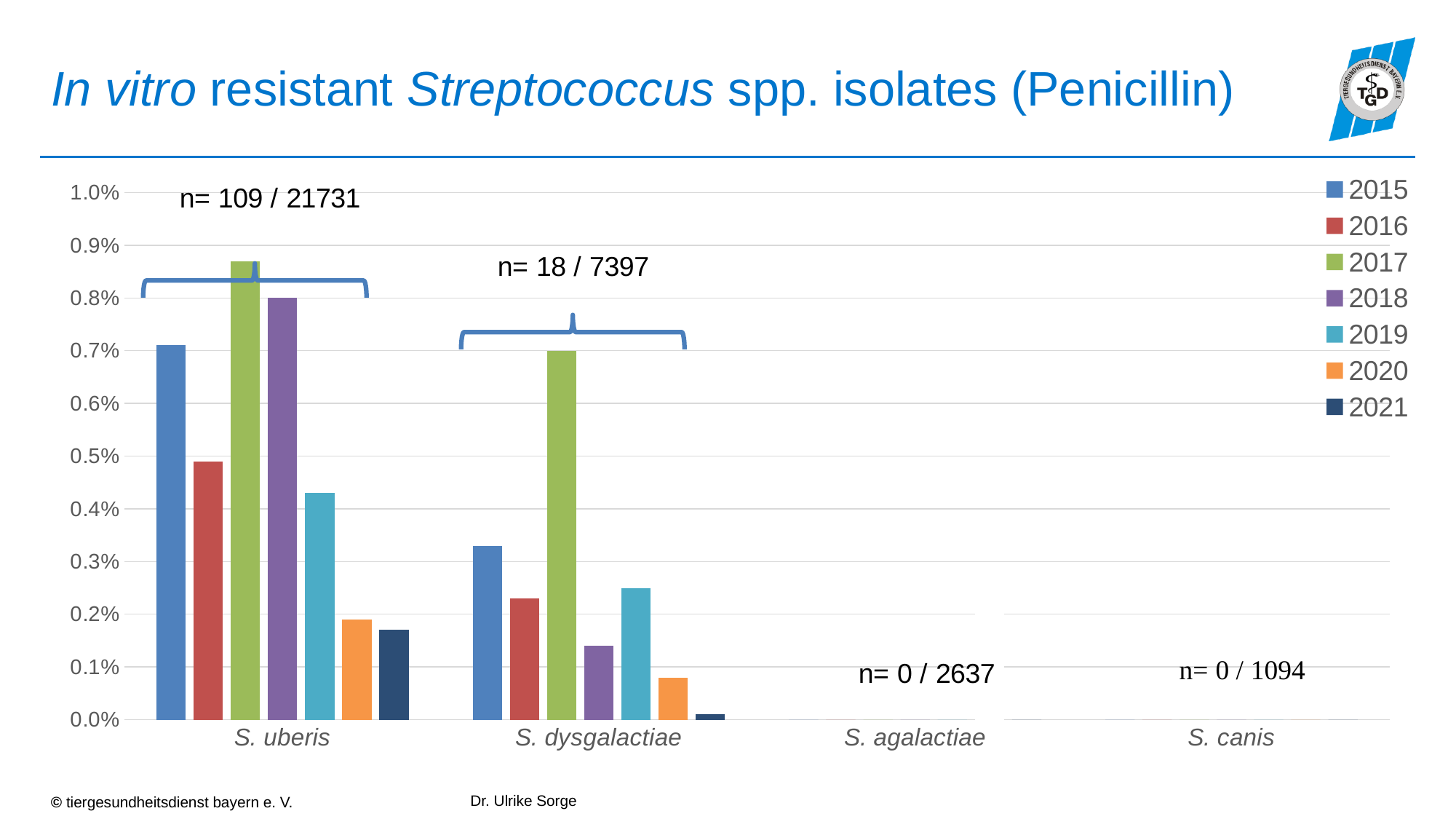
Is the value for S. uberis in 2015 greater or less than 0.6%? greater Is the value for S. dysgalactiae in 2015 greater or less than 0.4%? less What is the n value annotated above the S. uberis bars? n= 109 / 21731 What is the n value annotated for S. agalactiae? n= 0 / 2637 Which year has the highest value for S. dysgalactiae? 2017 Which year has the lowest value for S. dysgalactiae? 2021 Which year has the highest value for S. uberis? 2017 How many series does the legend list? 7 What kind of chart is shown on the slide? bar chart How many species categories are shown on the x axis? 4 Which is larger, the 2016 value for S. uberis or the 2016 value for S. dysgalactiae? S. uberis Is the value for S. uberis in 2019 greater or less than 0.5%? less